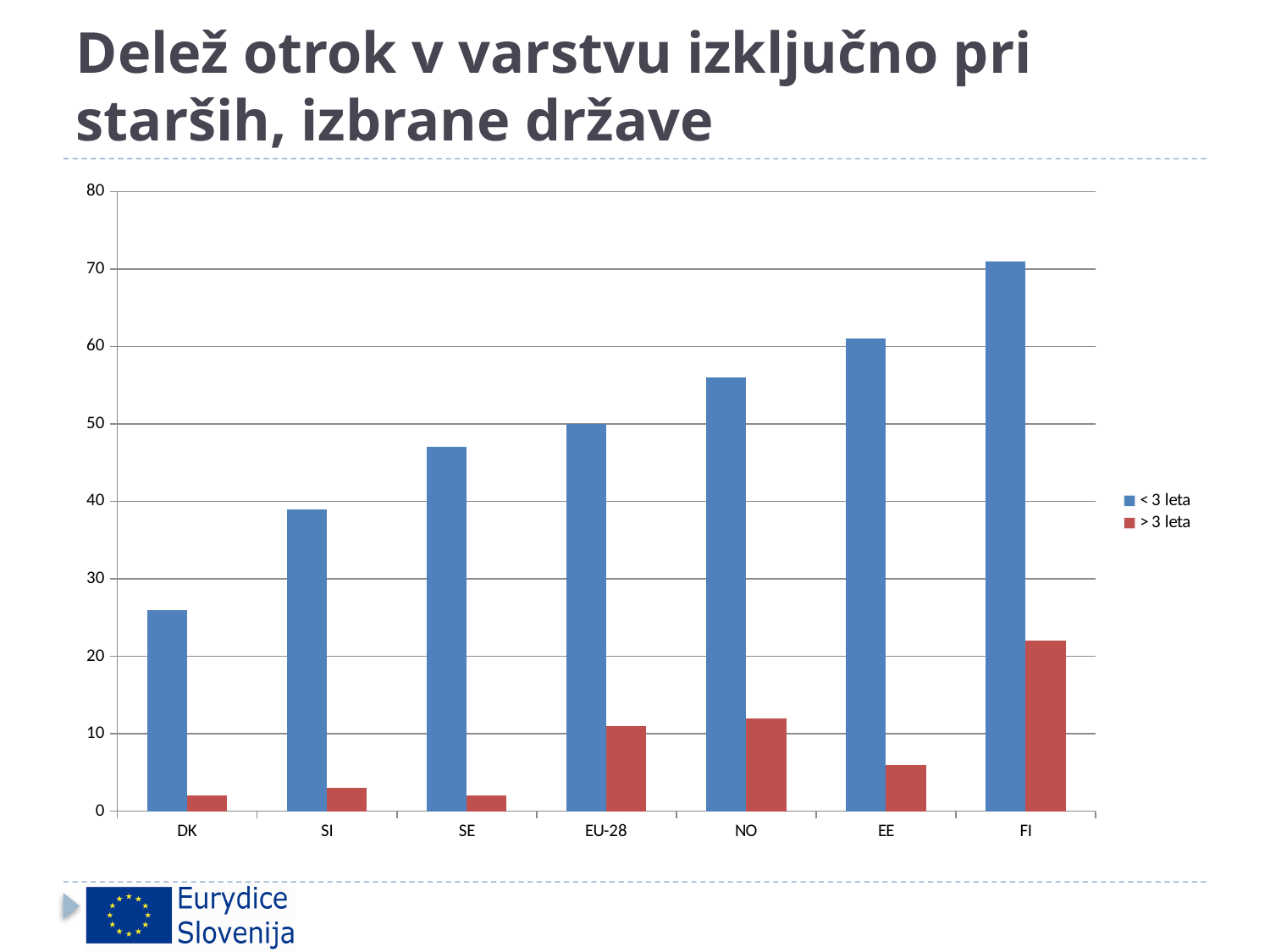
Is the '< 3 leta' value for DK greater or less than 30? less Which category has the highest value for the '> 3 leta' series? FI Is the '> 3 leta' value for FI greater or less than 20? greater Which category has the highest value for the '< 3 leta' series? FI Which is larger: the '< 3 leta' value for SI or for SE? SE Which category has the lowest value for the '< 3 leta' series? DK Do the '< 3 leta' values rise or fall from DK to FI along the x axis? rise What are the two legend entries of the chart? < 3 leta and > 3 leta How many series does the legend list? 2 What kind of chart is shown on the slide? bar chart How many countries/categories are shown on the x axis? 7